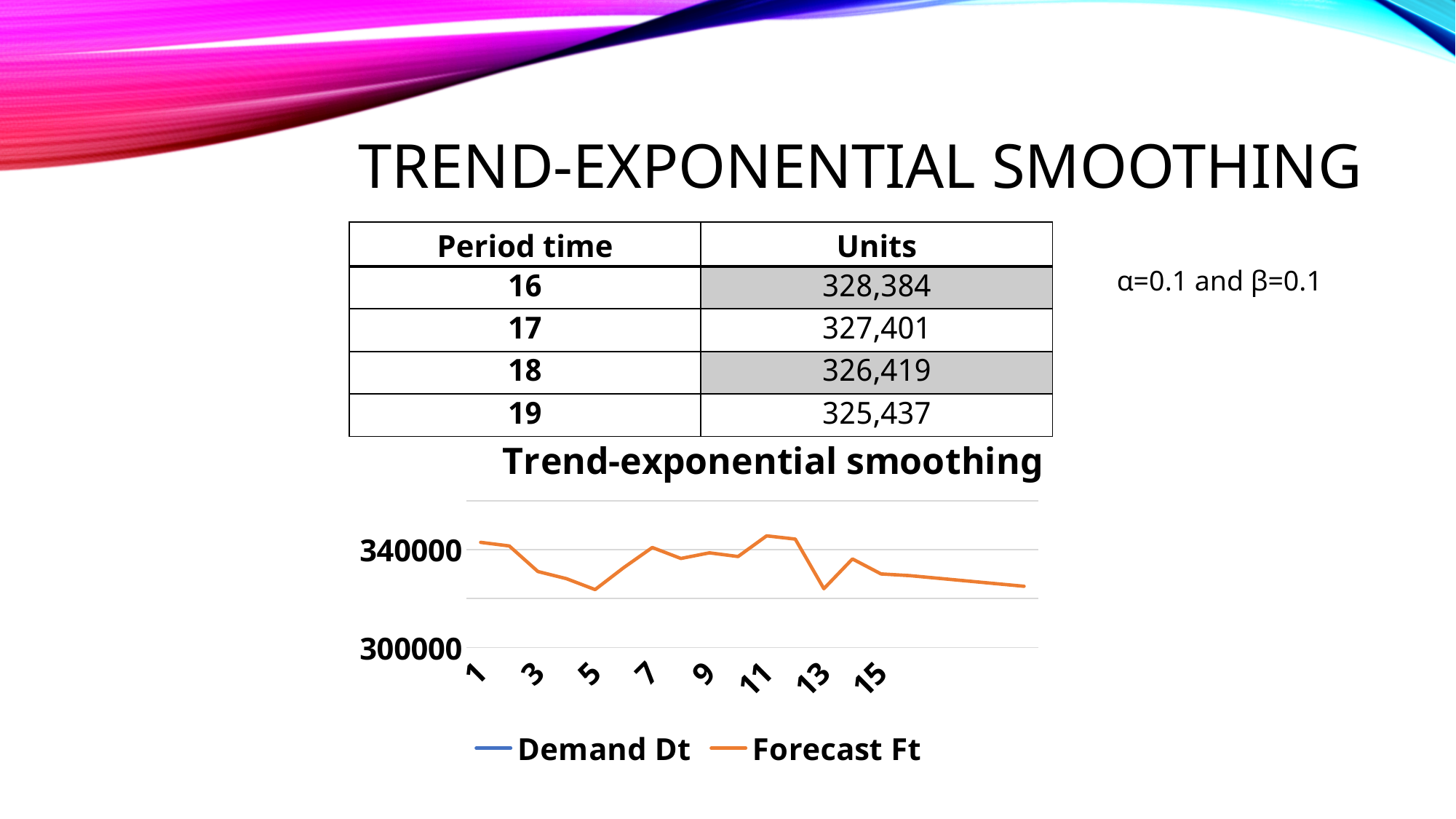
Which has the larger Forecast Ft value, period 5 or period 11? period 11 Does the Forecast Ft line rise or fall from period 15 to the end of the series? fall Is the Forecast Ft value at period 11 greater or less than 340000? greater How many series does the chart legend list? 2 Is the Forecast Ft value at period 13 greater or less than 300000? greater What are the two series named in the chart legend? Demand Dt and Forecast Ft What is the title of the chart? Trend-exponential smoothing Is the Forecast Ft value at period 5 greater or less than 340000? less At which period does the Forecast Ft line reach its highest point? 11 Which has the larger Forecast Ft value, period 1 or period 5? period 1 What kind of chart is shown on the slide? line chart